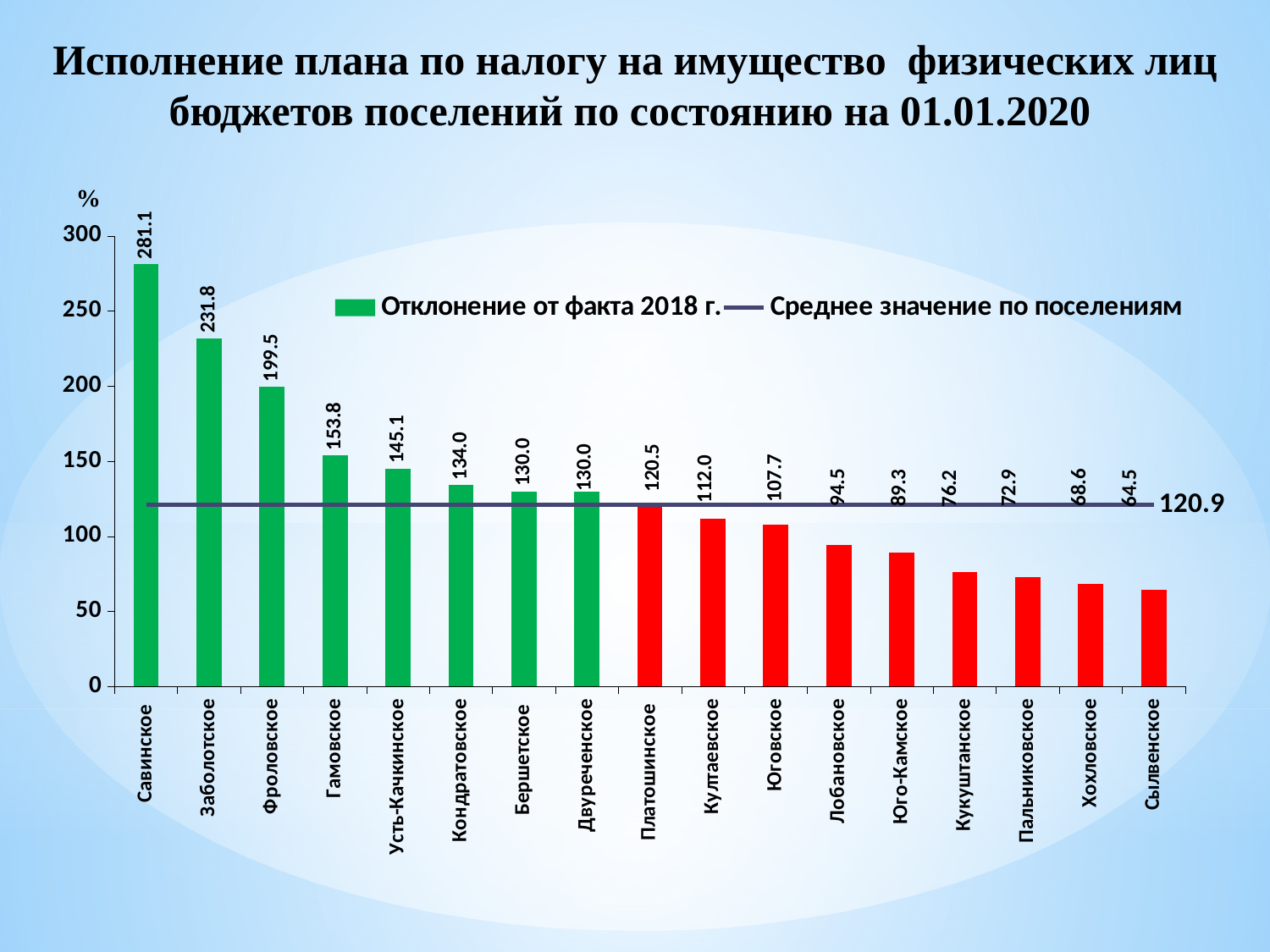
How many entries does the legend list? 2 What is the value for Сылвенское? 64.5 What kind of chart is shown on the slide? combination bar and line chart How many settlements are shown on the x axis? 17 Which settlement has the lowest value? Сылвенское What value is shown for the average line (Среднее значение по поселениям)? 120.9 What is the difference between the values for Савинское and Заболотское? 49.3 Which settlement has the highest value? Савинское Do the bar values rise or fall from left to right along the x axis? fall What is the value for Кондратовское? 134.0 Which is larger, the value for Гамовское or the value for Усть-Качкинское? Гамовское What is the value for Савинское? 281.1